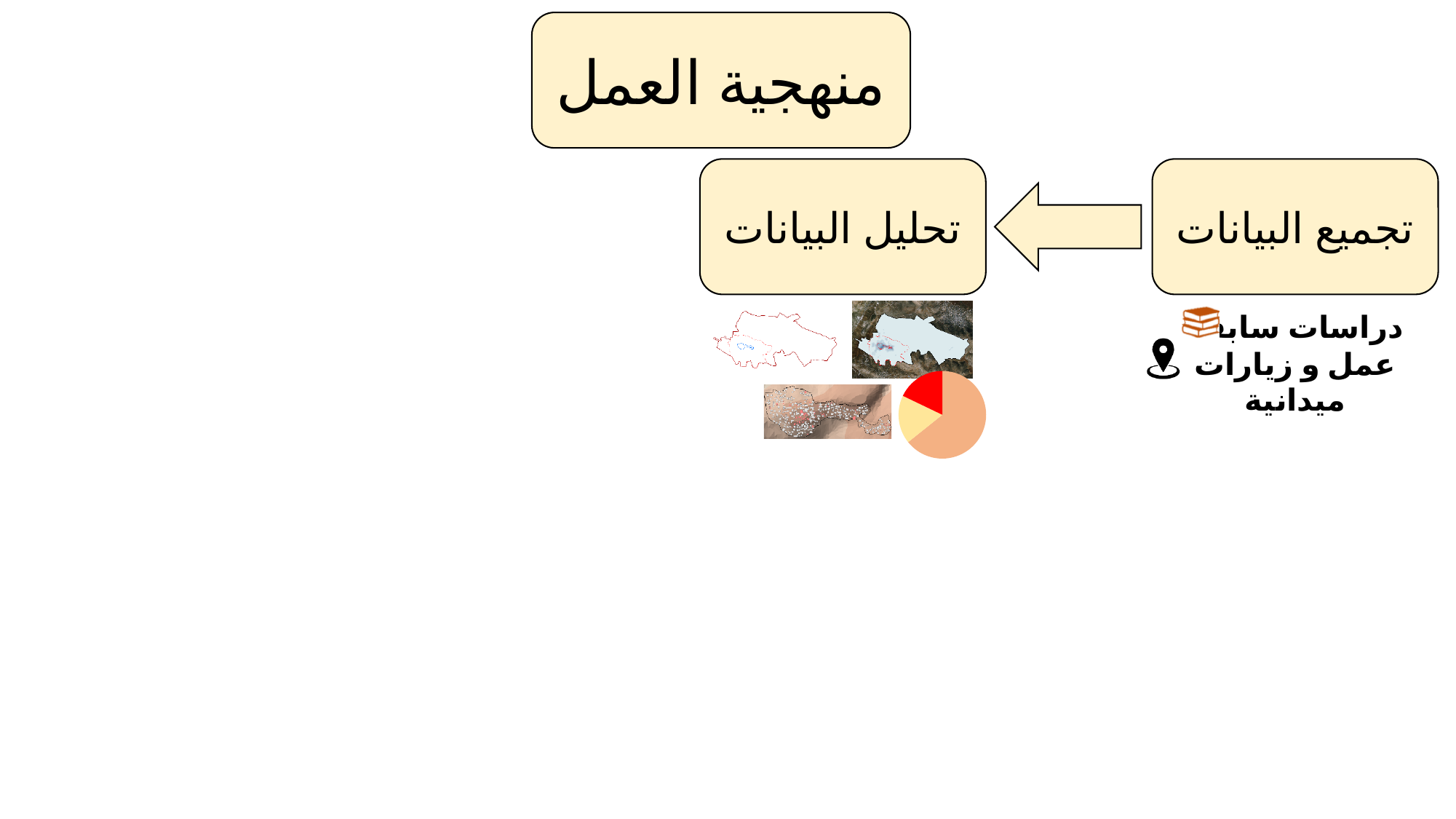
In the pie chart, which is larger, the yellow slice or the orange slice? orange Does the pie chart have a legend? No In the pie chart, which is larger, the red slice or the orange slice? orange How many slices does the pie chart have? 3 Which colour slice is the largest in the pie chart? orange What colours are the slices of the pie chart? red, yellow and orange What kind of chart is shown on the slide? pie chart